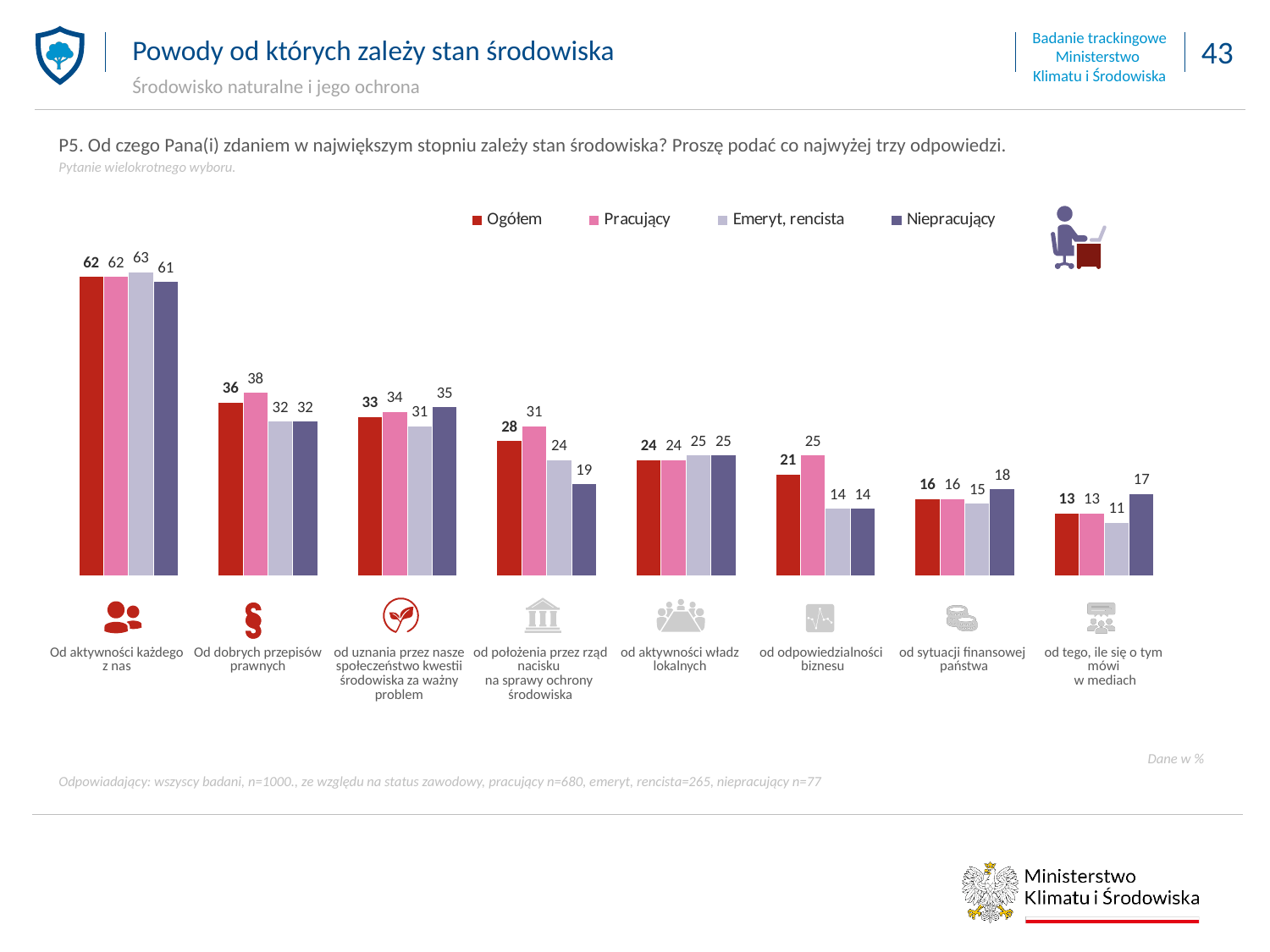
How many series does the legend list? 4 Which category has the highest value for Ogółem? Od aktywności każdego z nas What is the value for Emeryt, rencista in the category "od odpowiedzialności biznesu"? 14 In the category "od odpowiedzialności biznesu", which is larger: the value for Pracujący or the value for Niepracujący? Pracujący How many categories are shown on the chart? 8 What kind of chart is shown on the slide? bar chart What is the difference between the Pracujący and Emeryt, rencista values in the category "Od dobrych przepisów prawnych"? 6 Do the Ogółem values rise or fall moving from left to right across the categories? fall Which series is shown in red in the legend? Ogółem What is the value for Niepracujący in the category "od położenia przez rząd nacisku na sprawy ochrony środowiska"? 19 What is the value for Ogółem in the category "Od aktywności każdego z nas"? 62 Which category has the lowest value for Emeryt, rencista? od tego, ile się o tym mówi w mediach